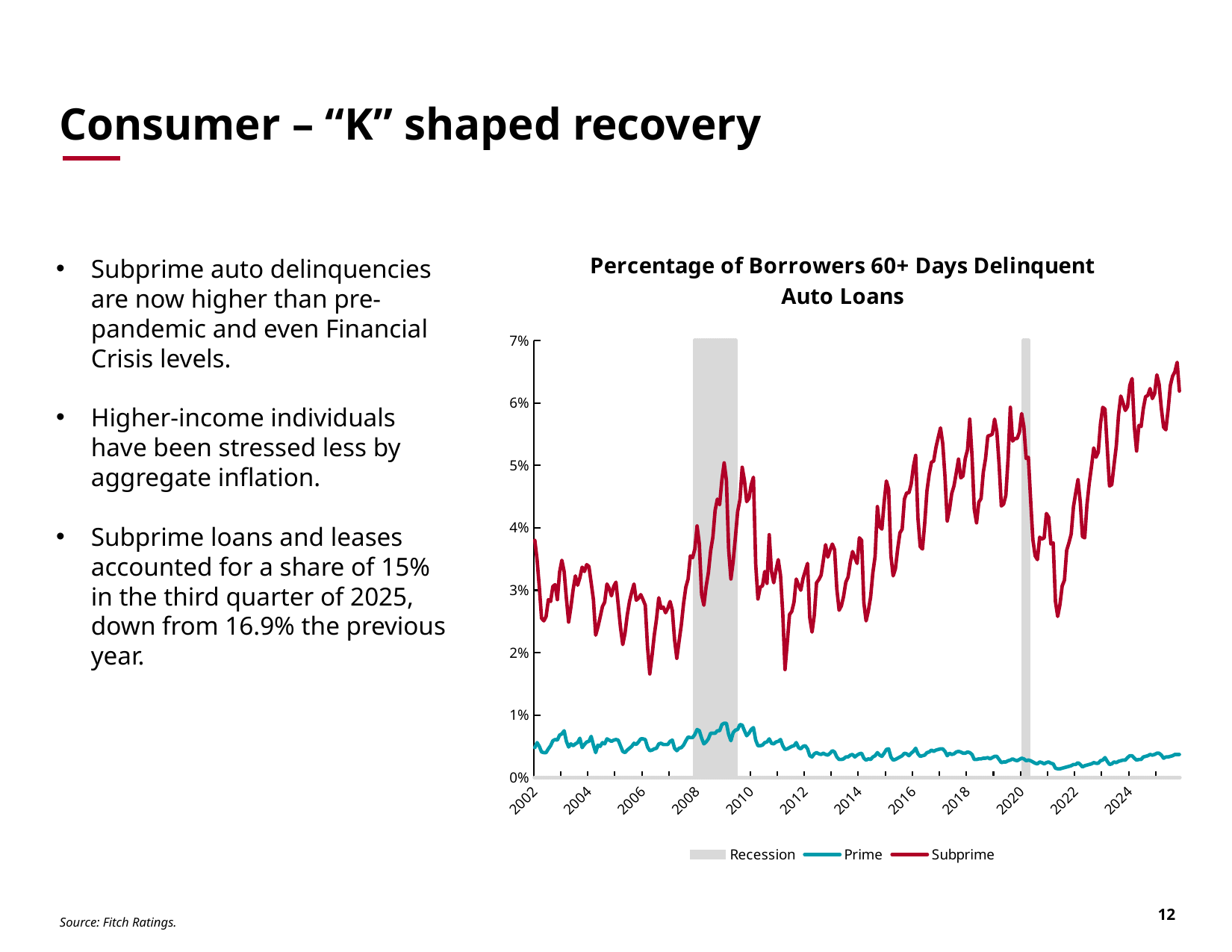
What is the highest value shown on the chart's vertical axis? 7% How many entries does the chart's legend list? 3 Which series has higher delinquency values throughout the chart, Prime or Subprime? Subprime Is the lowest Subprime delinquency value around 2007 greater or less than 2%? less Is the Prime delinquency rate greater or less than 1% across the whole period shown? less What kind of chart is shown on the slide? line chart Does the Prime delinquency rate generally rise or fall between 2010 and 2022? fall Is the Subprime delinquency rate in 2024 greater or less than 5%? greater What is the title of the chart? Percentage of Borrowers 60+ Days Delinquent Auto Loans What do the grey shaded areas on the chart represent? Recession Does the Subprime delinquency rate generally rise or fall between 2012 and 2024? rise